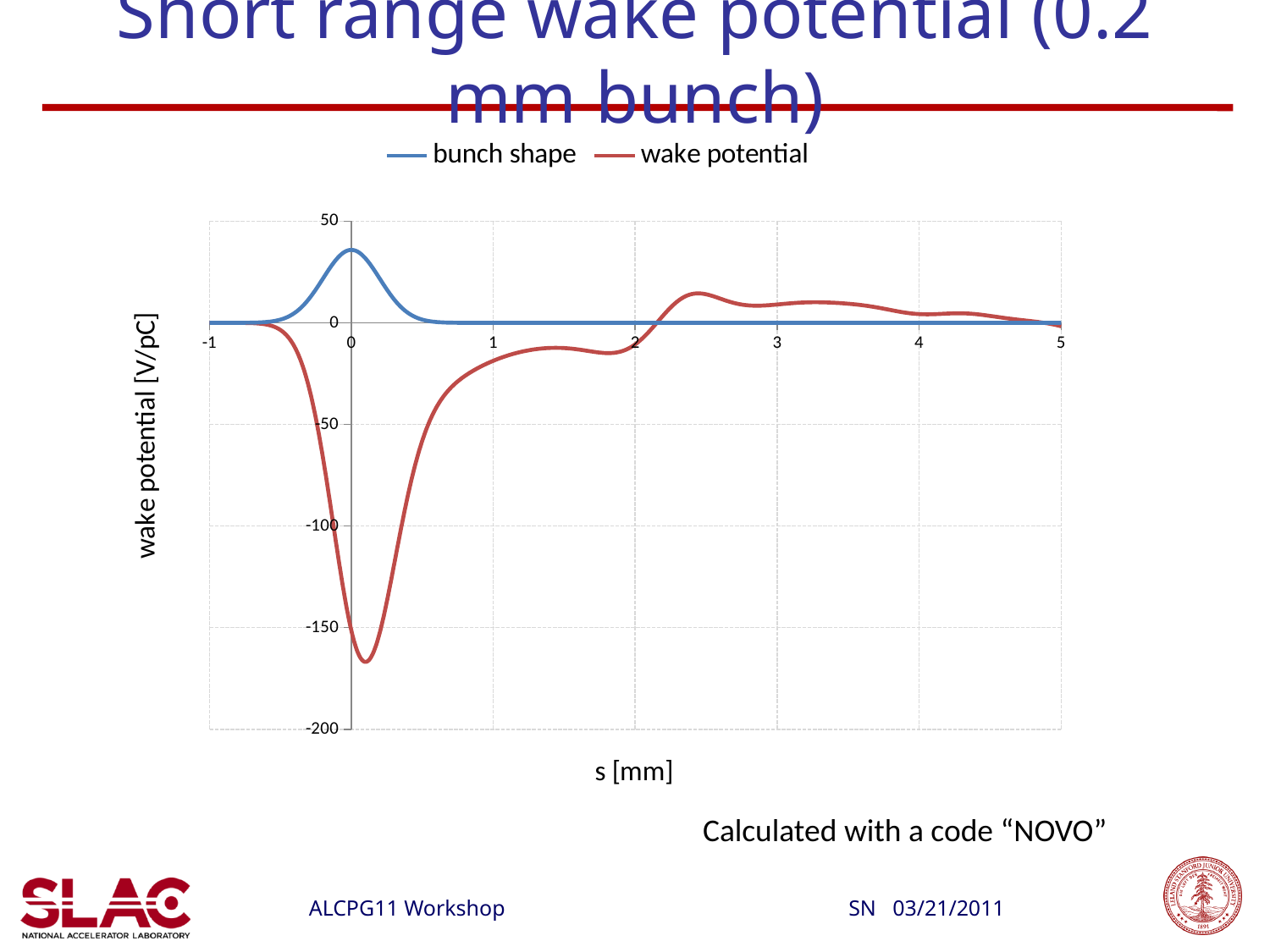
Is the minimum value of the wake potential curve greater or less than -150? less Is the wake potential at s = 2.5 mm greater or less than 0? greater How many series does the legend list? 2 Between s = -0.5 mm and s = 0 mm, does the wake potential curve rise or fall? fall Is the wake potential at s = 1 mm greater or less than -50? greater Which series reaches the lowest value on the chart? wake potential Between s = 0 mm and s = 1 mm, does the wake potential curve rise or fall? rise Which series reaches the higher peak value, bunch shape or wake potential? bunch shape What are the two series named in the legend? bunch shape and wake potential What kind of chart is shown on the slide? line chart What is the label of the x axis? s [mm]